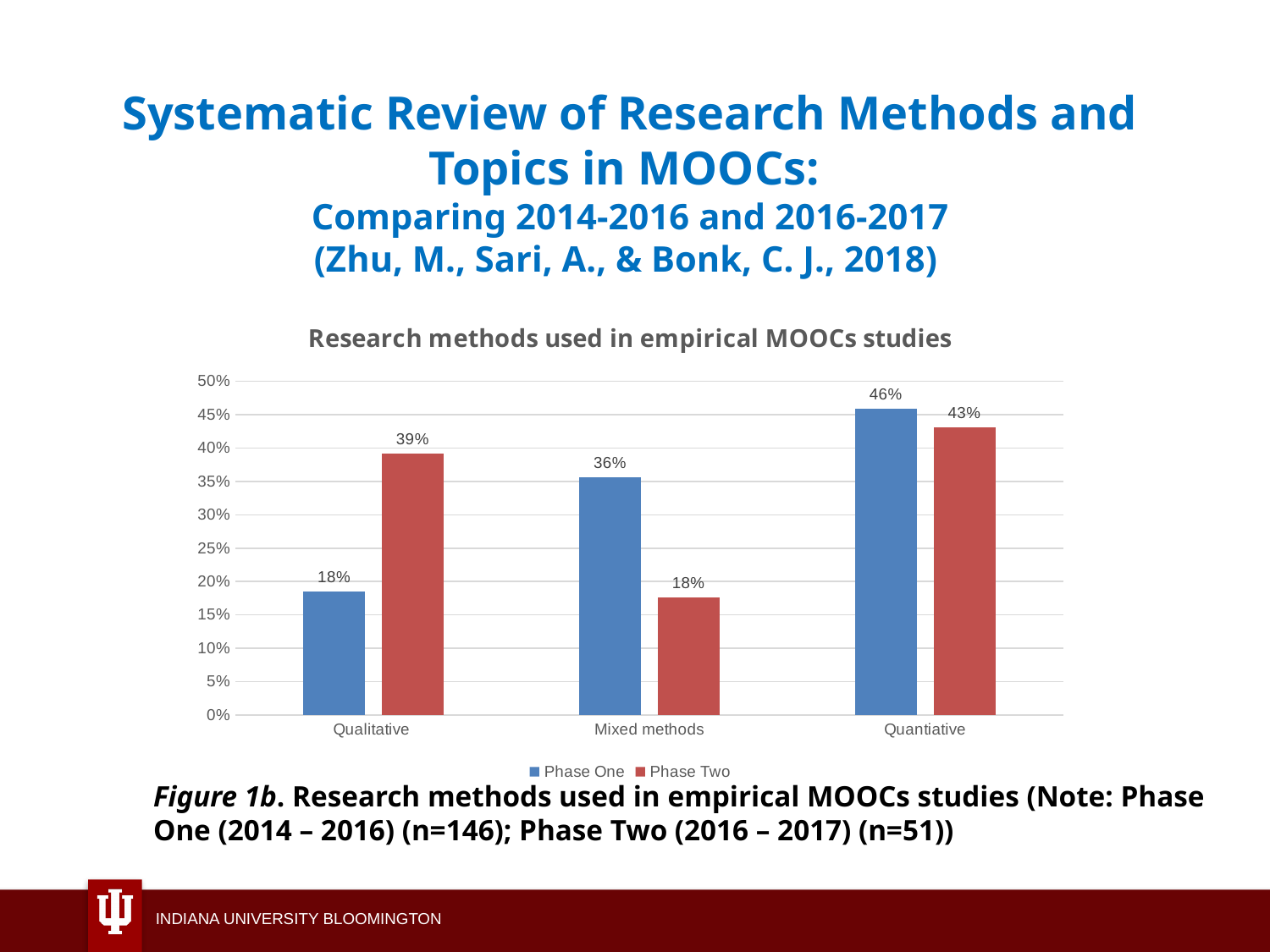
What is the Phase One value for Qualitative? 18% What is the Phase Two value for Mixed methods? 18% Which category has the lowest Phase Two value? Mixed methods What is the difference between the Phase Two and Phase One values for Qualitative? 21% Which is larger for Quantiative, Phase One or Phase Two? Phase One How many categories are shown on the x axis? 3 What is the difference between the Phase One and Phase Two values for Mixed methods? 18% What is the title of the chart? Research methods used in empirical MOOCs studies How many series does the legend list? 2 What is the Phase Two value for Quantiative? 43% What kind of chart is shown? Bar chart Which category has the highest Phase One value? Quantiative